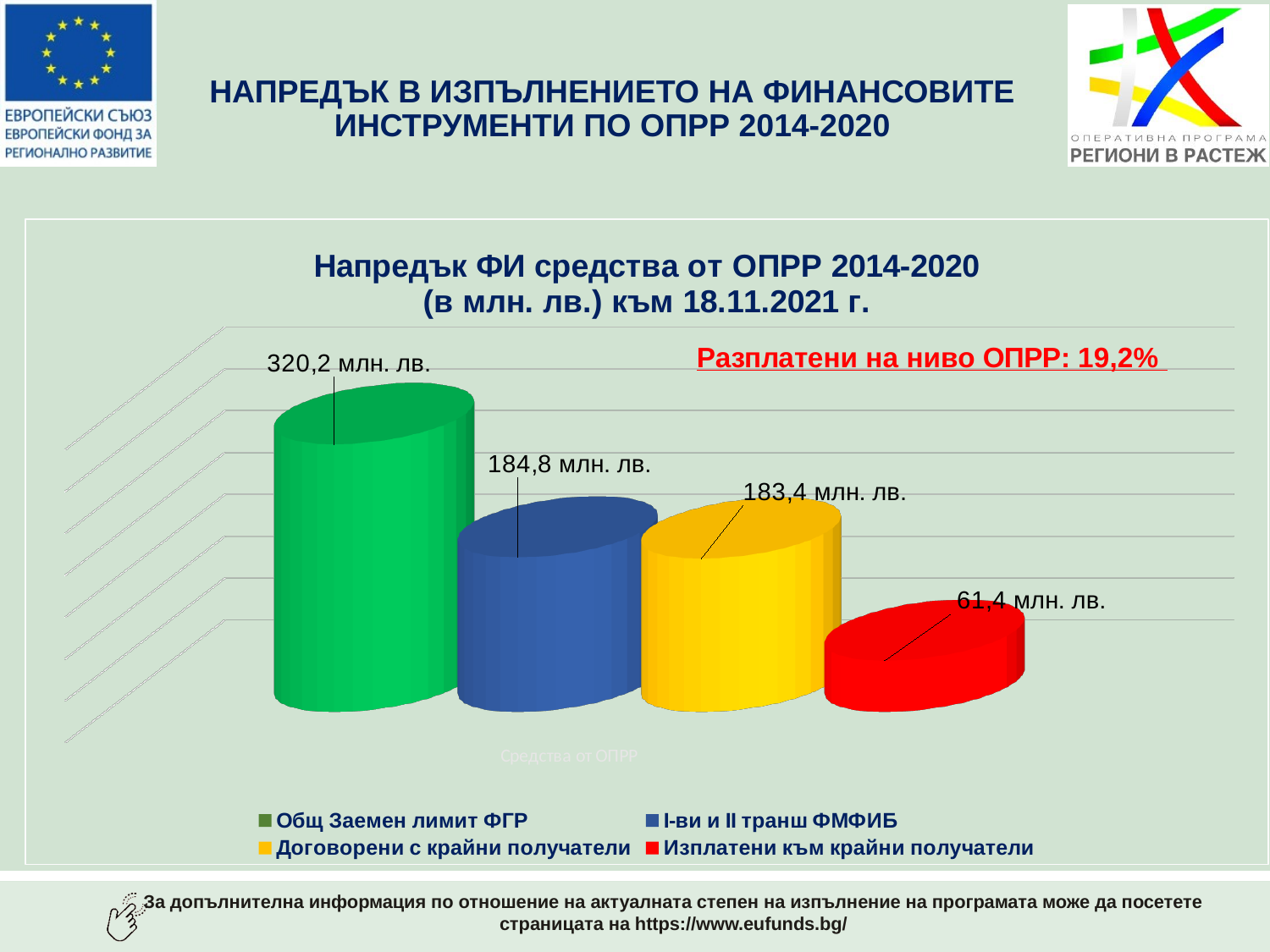
What is the value for I-ви и II транш ФМФИБ? 184,8 млн. лв. What is the difference between Общ Заемен лимит ФГР and I-ви и II транш ФМФИБ? 135,4 млн. лв. Which series has the highest value? Общ Заемен лимит ФГР Which series has the lowest value? Изплатени към крайни получатели Which is larger, I-ви и II транш ФМФИБ or Договорени с крайни получатели? I-ви и II транш ФМФИБ What is the difference between Договорени с крайни получатели and Изплатени към крайни получатели? 122,0 млн. лв. What is the value for Изплатени към крайни получатели? 61,4 млн. лв. What kind of chart is shown? Bar chart What percentage is given for Разплатени на ниво ОПРР? 19,2% What is the value for Общ Заемен лимит ФГР? 320,2 млн. лв. How many series does the legend list? 4 What is the value for Договорени с крайни получатели? 183,4 млн. лв.